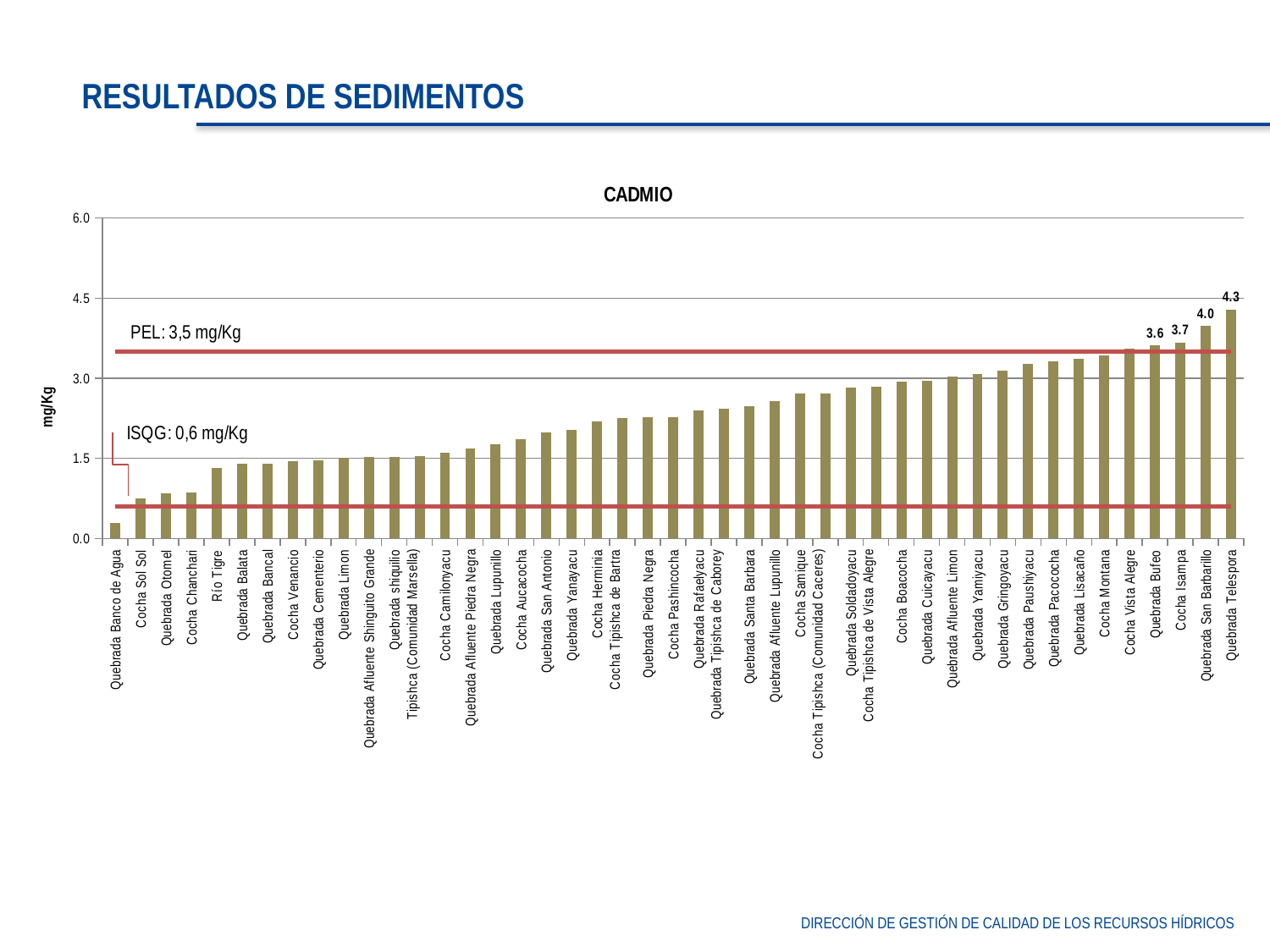
Which site has the lowest cadmium value? Quebrada Banco de Agua Is the value for Cocha Herminia greater or less than 1.5? greater Do the bar values rise or fall from left to right along the x axis? rise Which site has the highest cadmium value? Quebrada Telespora What is the value for Quebrada San Barbarillo? 4.0 What kind of chart is shown on the slide? bar chart What is the value for Quebrada Telespora? 4.3 What is the difference between the values for Quebrada Telespora and Quebrada Bufeo? 0.7 Which is larger, the value for Cocha Isampa or the value for Quebrada San Barbarillo? Quebrada San Barbarillo What is the title of the chart? CADMIO Is the value for Quebrada Santa Barbara greater or less than 3.0? less What is the value for Quebrada Bufeo? 3.6